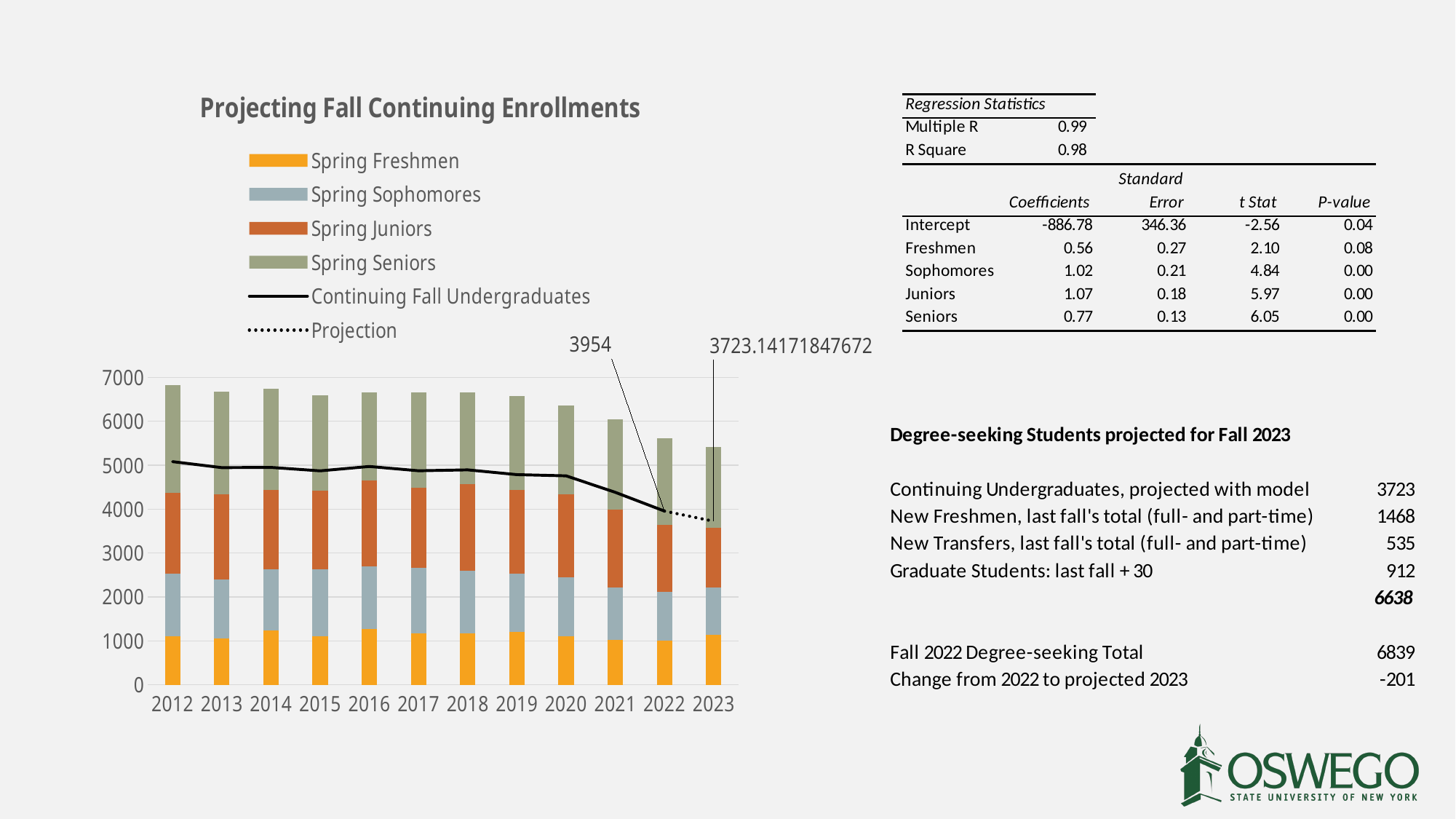
What is the labelled value of the Projection for 2023? 3723.14171847672 How many series does the chart's legend list? 6 Which is larger: the Continuing Fall Undergraduates value for 2022 or the Projection value for 2023? Continuing Fall Undergraduates for 2022 How many years are shown on the x axis of the chart? 12 Is the total stacked bar for 2012 greater or less than 6000? greater Which year has the shortest stacked bar? 2023 What is the labelled value of Continuing Fall Undergraduates for 2022? 3954 Is the total stacked bar for 2023 greater or less than 6000? less Which series in the legend is drawn as a dotted line? Projection What is the title of the chart? Projecting Fall Continuing Enrollments What kind of chart is shown on the slide? stacked bar chart with lines Does the Continuing Fall Undergraduates line rise or fall from 2012 to 2022? fall